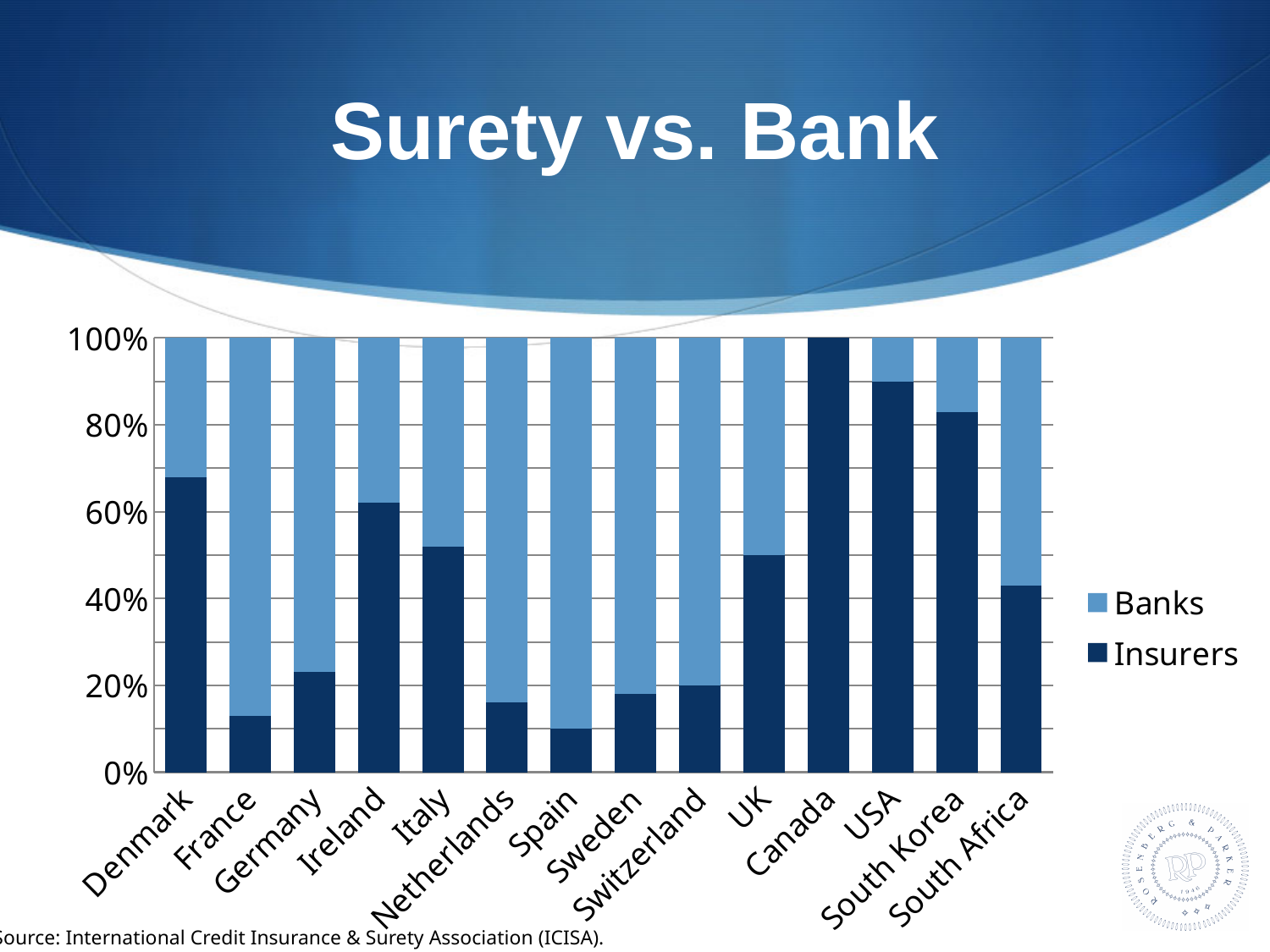
Is the Insurers share for USA greater or less than 80%? greater What is the Insurers share for Canada? 100% Is the Insurers share for Denmark greater or less than 60%? greater What is the title of the slide? Surety vs. Bank Is the Insurers share for Italy greater or less than 40%? greater What kind of chart is shown on the slide? Stacked bar chart Which has the larger Insurers share, Denmark or France? Denmark Which country has the highest Insurers share? Canada How many series does the legend list? 2 Which has the larger Banks share, Spain or USA? Spain How many countries are shown on the x axis? 14